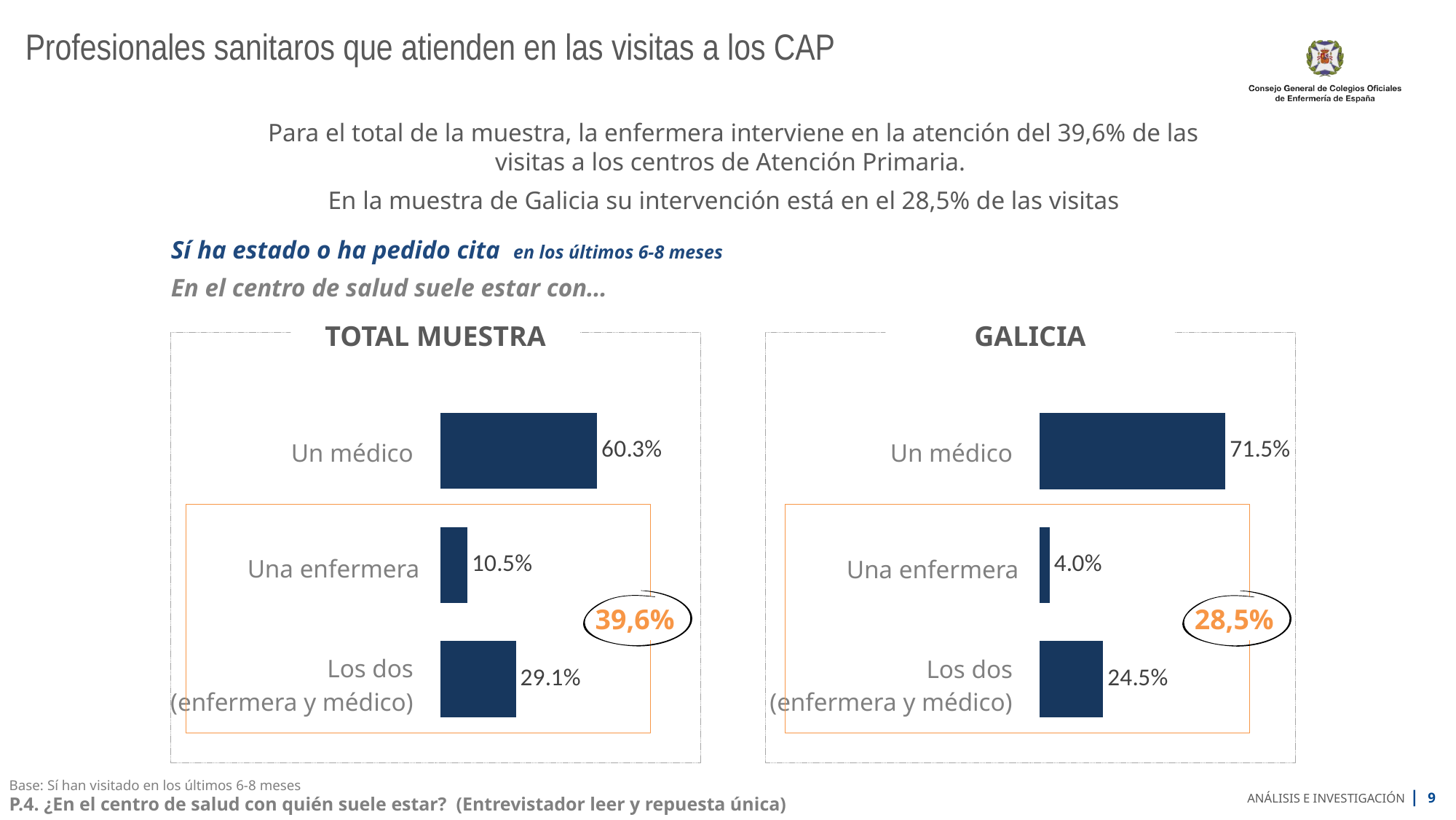
In the GALICIA chart, which category has the highest value? Un médico How many categories does the TOTAL MUESTRA chart show? 3 In the GALICIA chart, what is the value for Los dos (enfermera y médico)? 24.5% What value is shown in the orange circle on the GALICIA chart? 28,5% In the TOTAL MUESTRA chart, what is the value for Un médico? 60.3% Which is larger: Una enfermera in the TOTAL MUESTRA chart or Una enfermera in the GALICIA chart? TOTAL MUESTRA In the TOTAL MUESTRA chart, what is the value for Una enfermera? 10.5% What kind of chart is the GALICIA chart? Bar chart In the TOTAL MUESTRA chart, what is the difference between Un médico and Los dos (enfermera y médico)? 31.2% In the TOTAL MUESTRA chart, which category has the lowest value? Una enfermera In the GALICIA chart, what is the difference between Un médico and Una enfermera? 67.5% In the GALICIA chart, what is the value for Una enfermera? 4.0%